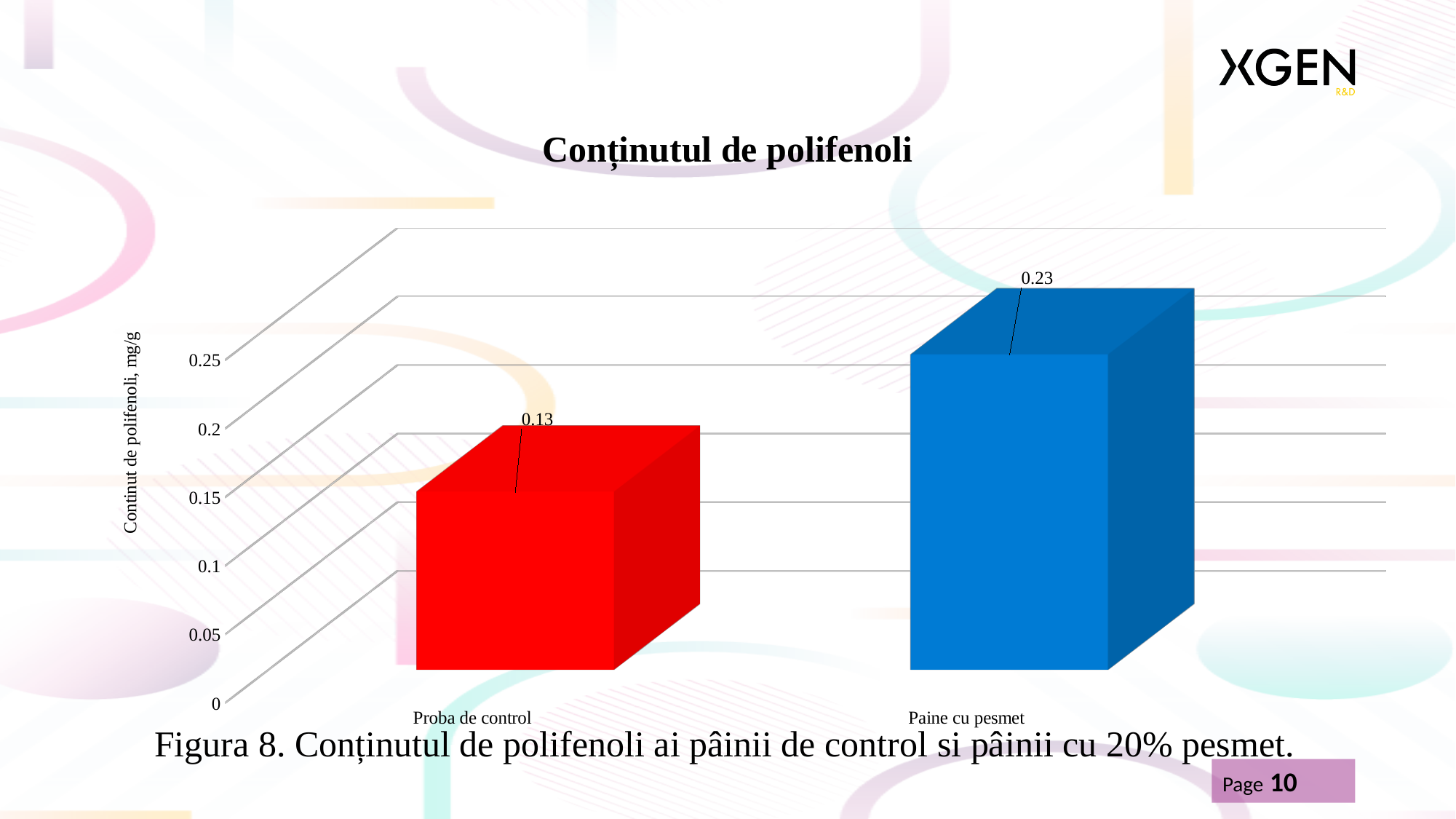
What is the difference between the values for Paine cu pesmet and Proba de control? 0.1 How many categories are shown in the chart? 2 Is the value for Paine cu pesmet greater or less than 0.2? greater Which category has the lowest polyphenol content? Proba de control What is the title of the chart? Conținutul de polifenoli Which has a larger value, Proba de control or Paine cu pesmet? Paine cu pesmet Is the value for Proba de control greater or less than 0.15? less What kind of chart is shown on the slide? Bar chart What is the polyphenol content value for Paine cu pesmet? 0.23 What is the polyphenol content value for Proba de control? 0.13 What is the label of the vertical axis? Continut de polifenoli, mg/g Which category has the highest polyphenol content? Paine cu pesmet